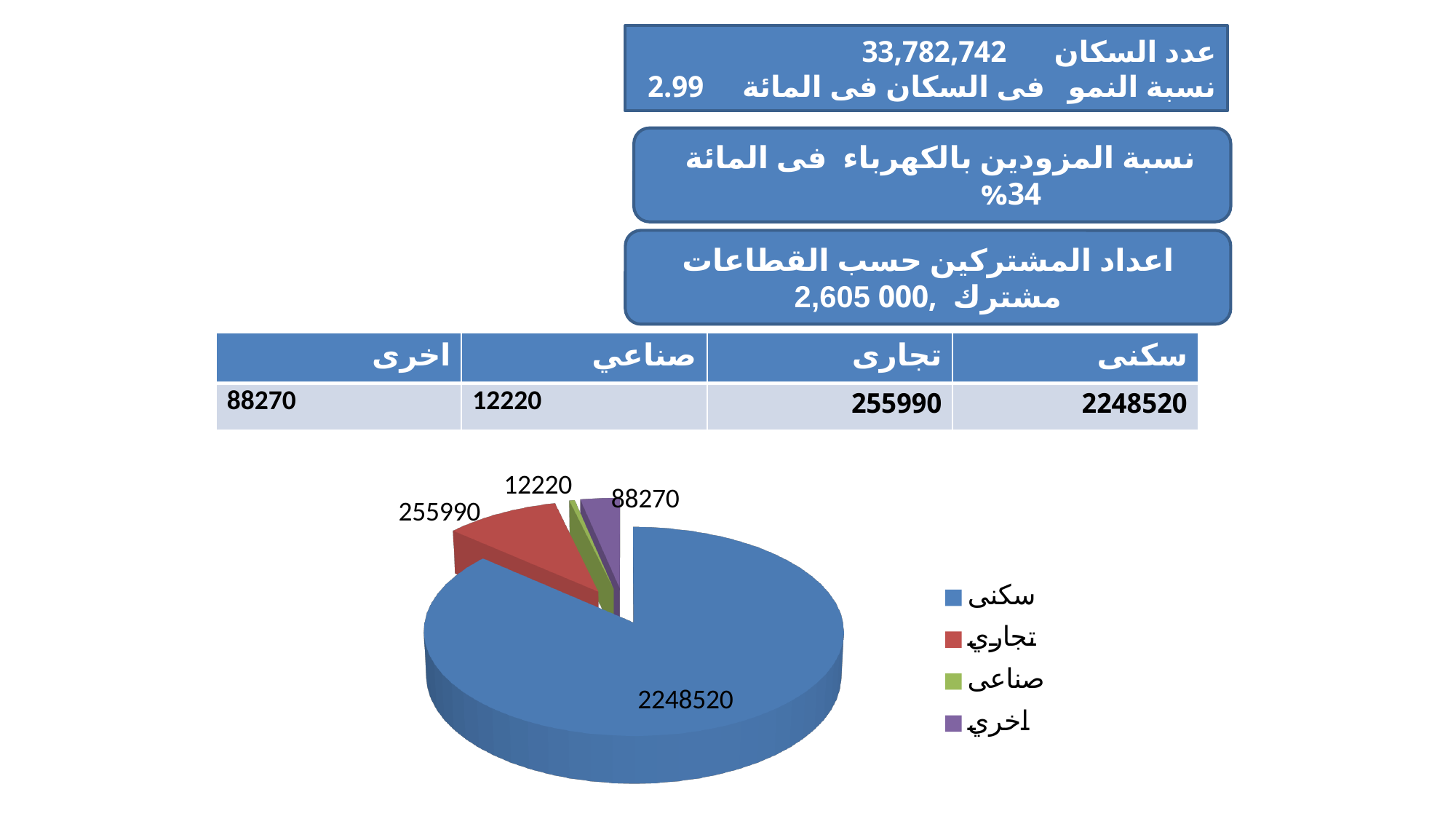
Which is larger in the pie chart, the اخرى slice or the صناعي slice? اخرى What is the value of the تجاري (commercial) slice in the pie chart? 255990 What colour is the سكنى slice in the pie chart? Blue What is the value of the اخرى (other) slice in the pie chart? 88270 What kind of chart is shown on the slide? Pie chart What is the value of the صناعي (industrial) slice in the pie chart? 12220 What is the difference between the سكنى and تجاري values in the pie chart? 1992530 What is the value of the سكنى (residential) slice in the pie chart? 2248520 Which category has the largest slice in the pie chart? سكنى Which category has the smallest slice in the pie chart? صناعي How many entries does the pie chart's legend list? 4 How many slices does the pie chart have? 4